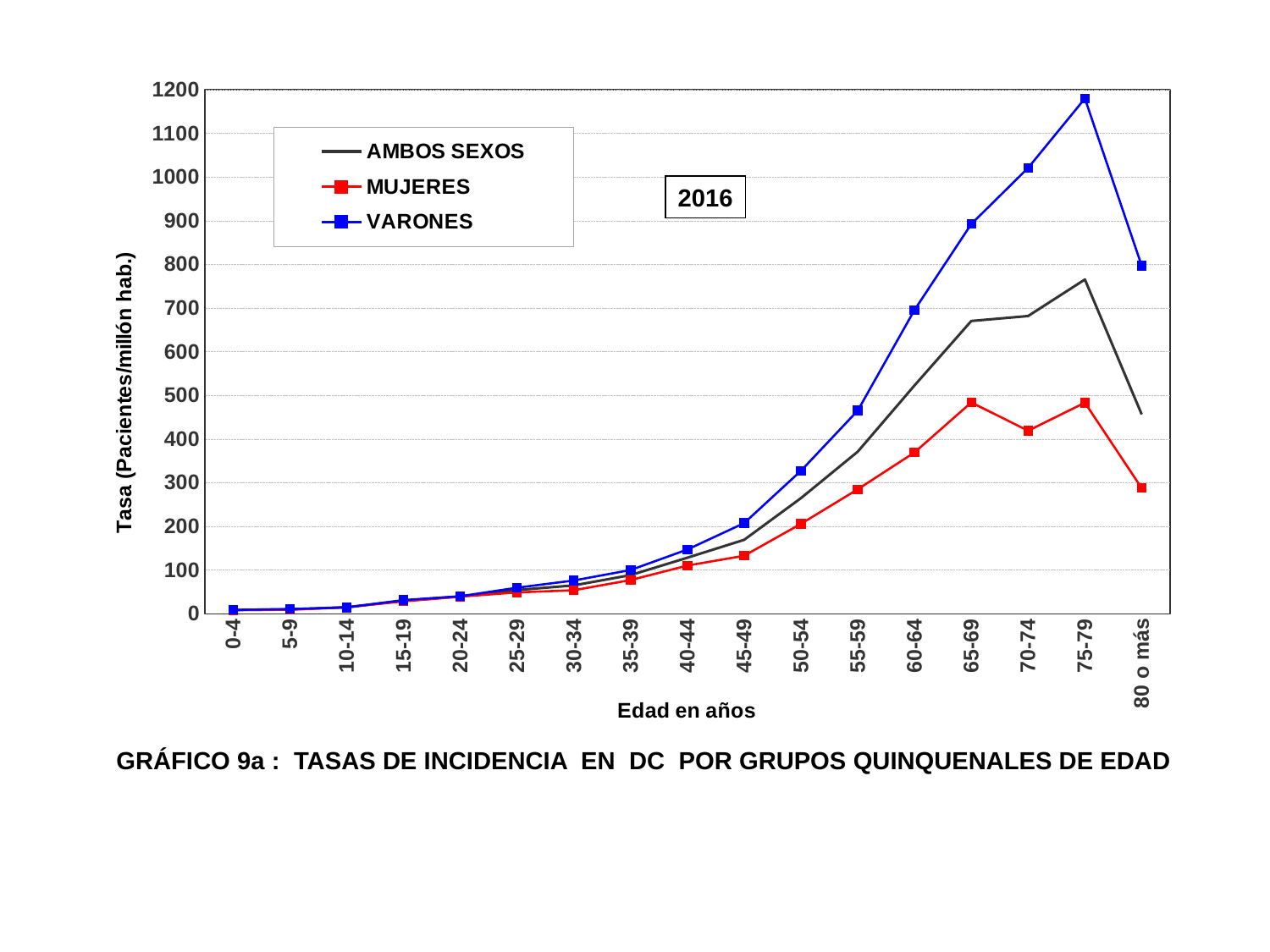
Is the value for MUJERES in the 70-74 age group greater or less than 400? greater Which series has the highest value in the 75-79 age group? VARONES What kind of chart is shown on the slide? Line chart Which is larger for MUJERES: the value for 65-69 or the value for 70-74? 65-69 Do the VARONES values rise or fall from the 75-79 age group to the 80 o más age group? fall Is the value for VARONES in the 55-59 age group greater or less than 500? less What year is shown in the box on the chart? 2016 How many age groups are shown on the x axis? 17 Which age group has the highest value for VARONES? 75-79 How many series does the legend list? 3 Is the value for VARONES in the 75-79 age group greater or less than 1100? greater